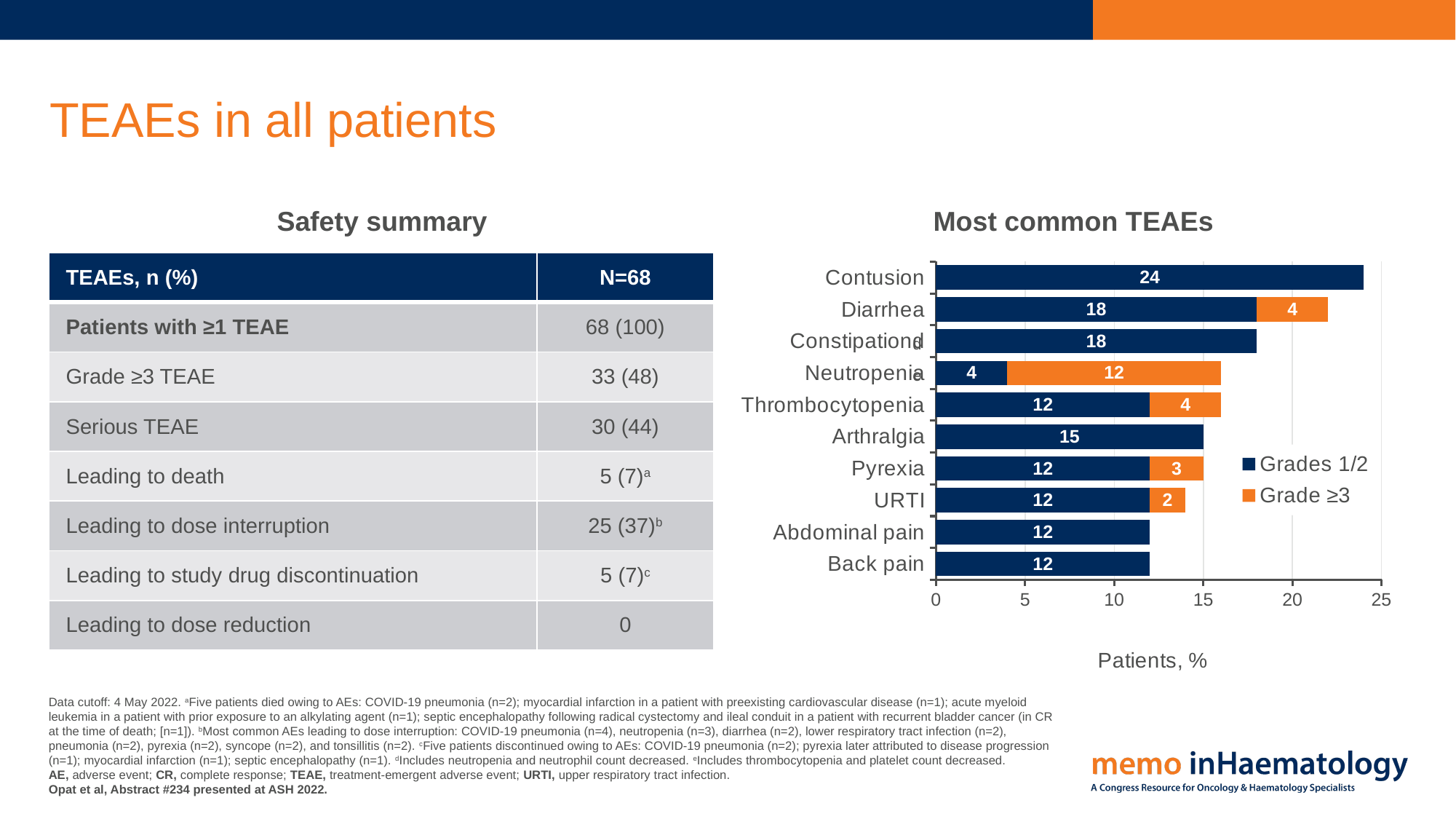
In the "Most common TEAEs" chart, what is the Grade ≥3 value for Neutropenia? 12 In the "Most common TEAEs" chart, what is the Grades 1/2 value for Contusion? 24 In the "Most common TEAEs" chart, what is the Grades 1/2 value for Arthralgia? 15 In the "Most common TEAEs" chart, which TEAE has the highest Grades 1/2 value? Contusion What kind of chart is the "Most common TEAEs" chart? Stacked bar chart In the "Most common TEAEs" chart, what is the difference between the Grade ≥3 values for Pyrexia and URTI? 1 In the "Most common TEAEs" chart, what is the total of the stacked bar for Thrombocytopenia? 16 In the "Most common TEAEs" chart, what is the total of the stacked bar for Diarrhea? 22 In the "Most common TEAEs" chart, which TEAE has the highest Grade ≥3 value? Neutropenia In the "Most common TEAEs" chart, what is the Grade ≥3 value for Diarrhea? 4 How many TEAE categories are shown in the "Most common TEAEs" chart? 10 How many series does the legend of the "Most common TEAEs" chart list? 2